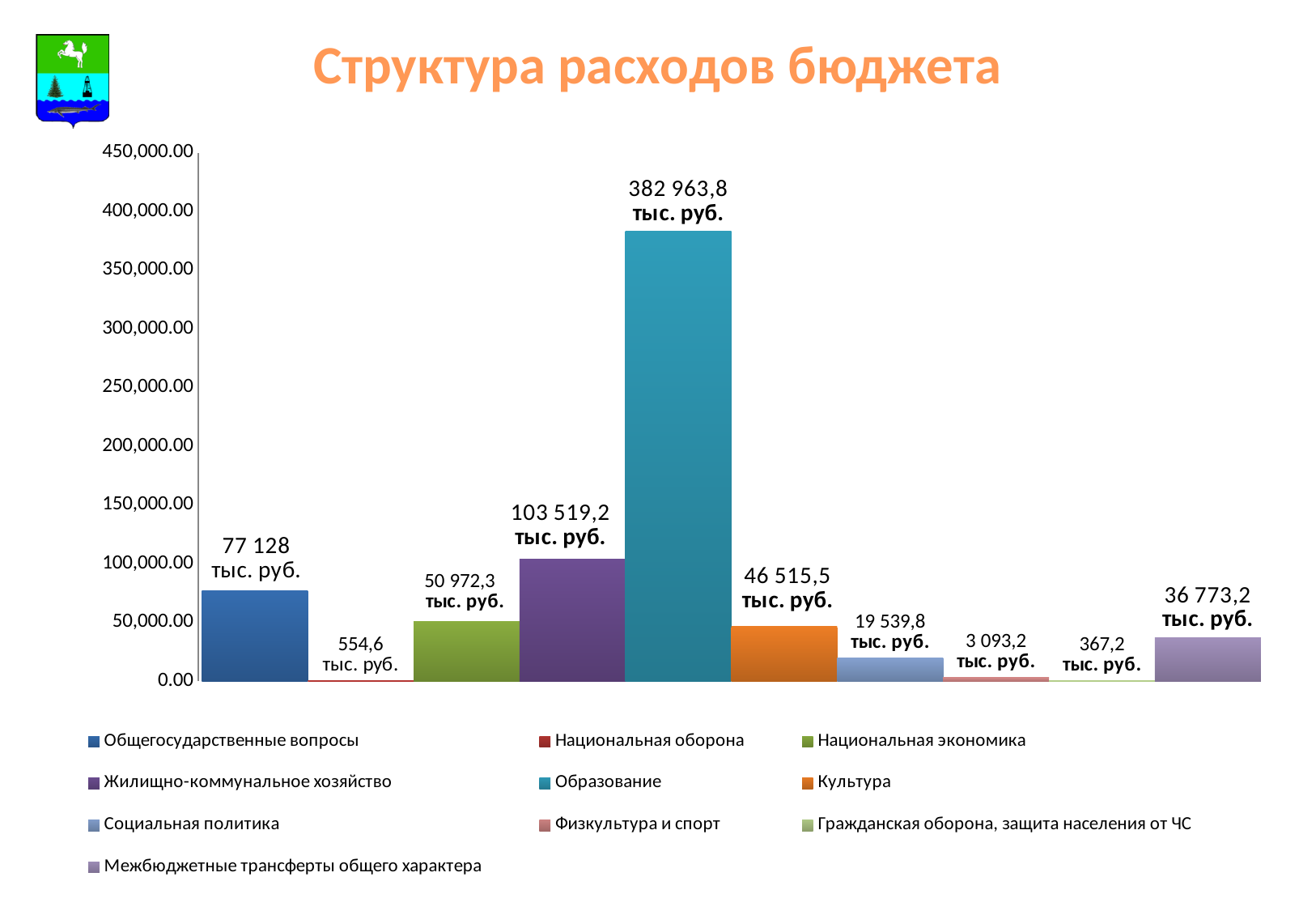
Which is larger, Культура or Социальная политика? Культура What is the value for Национальная оборона? 554,6 тыс. руб. What is the value for Общегосударственные вопросы? 77 128 тыс. руб. Is the value for Жилищно-коммунальное хозяйство greater or less than 100,000.00? greater What is the value for Образование? 382 963,8 тыс. руб. What kind of chart is shown on the slide? bar chart Which category has the highest value? Образование What is the value for Межбюджетные трансферты общего характера? 36 773,2 тыс. руб. How many series does the legend list? 10 Which category has the lowest value? Гражданская оборона, защита населения от ЧС What is the difference between Общегосударственные вопросы and Национальная экономика? 26 155,7 тыс. руб. What is the difference between Образование and Жилищно-коммунальное хозяйство? 279 444,6 тыс. руб.